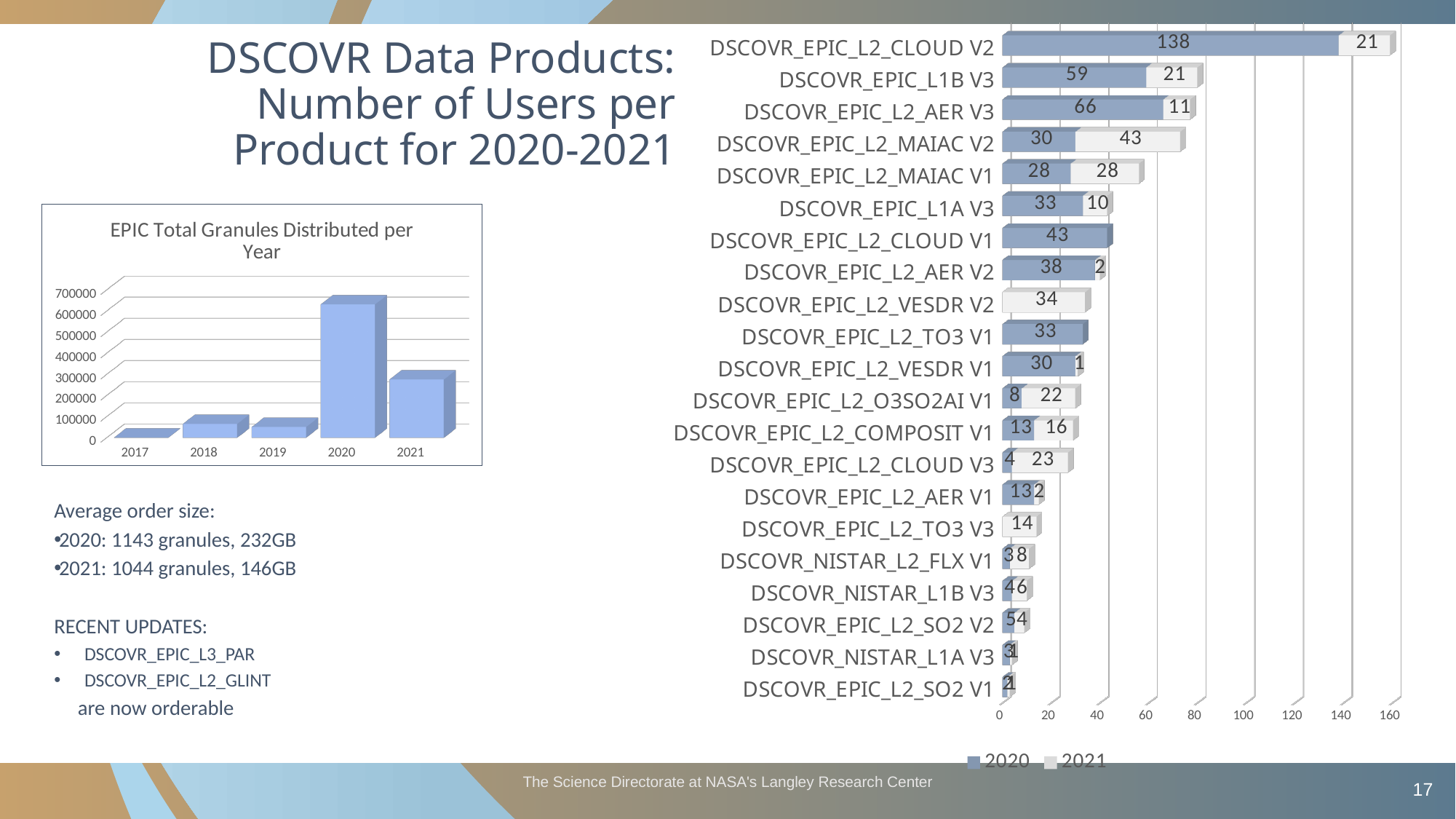
In the right-hand chart of users per product, which product has the highest 2020 value? DSCOVR_EPIC_L2_CLOUD V2 How many series does the legend of the right-hand chart of users per product list? 2 What kind of chart is 'EPIC Total Granules Distributed per Year'? bar chart In the right-hand chart of users per product, what is the 2020 value for DSCOVR_EPIC_L2_CLOUD V2? 138 In the chart titled 'EPIC Total Granules Distributed per Year', which year has the highest value? 2020 In the right-hand chart of users per product, what is the difference between the 2020 and 2021 values for DSCOVR_EPIC_L2_O3SO2AI V1? 14 In the right-hand chart of users per product, what is the 2020 value for DSCOVR_EPIC_L1B V3? 59 In the right-hand chart of users per product, which is larger for DSCOVR_EPIC_L2_CLOUD V3: the 2020 value or the 2021 value? 2021 In the right-hand chart of users per product, what is the 2021 value for DSCOVR_EPIC_L2_MAIAC V2? 43 In the right-hand chart of users per product, what is the total of the stacked bar for DSCOVR_EPIC_L2_AER V3? 77 How many products are listed in the right-hand chart of users per product? 21 In the chart titled 'EPIC Total Granules Distributed per Year', is the value for 2017 greater or less than 100000? less